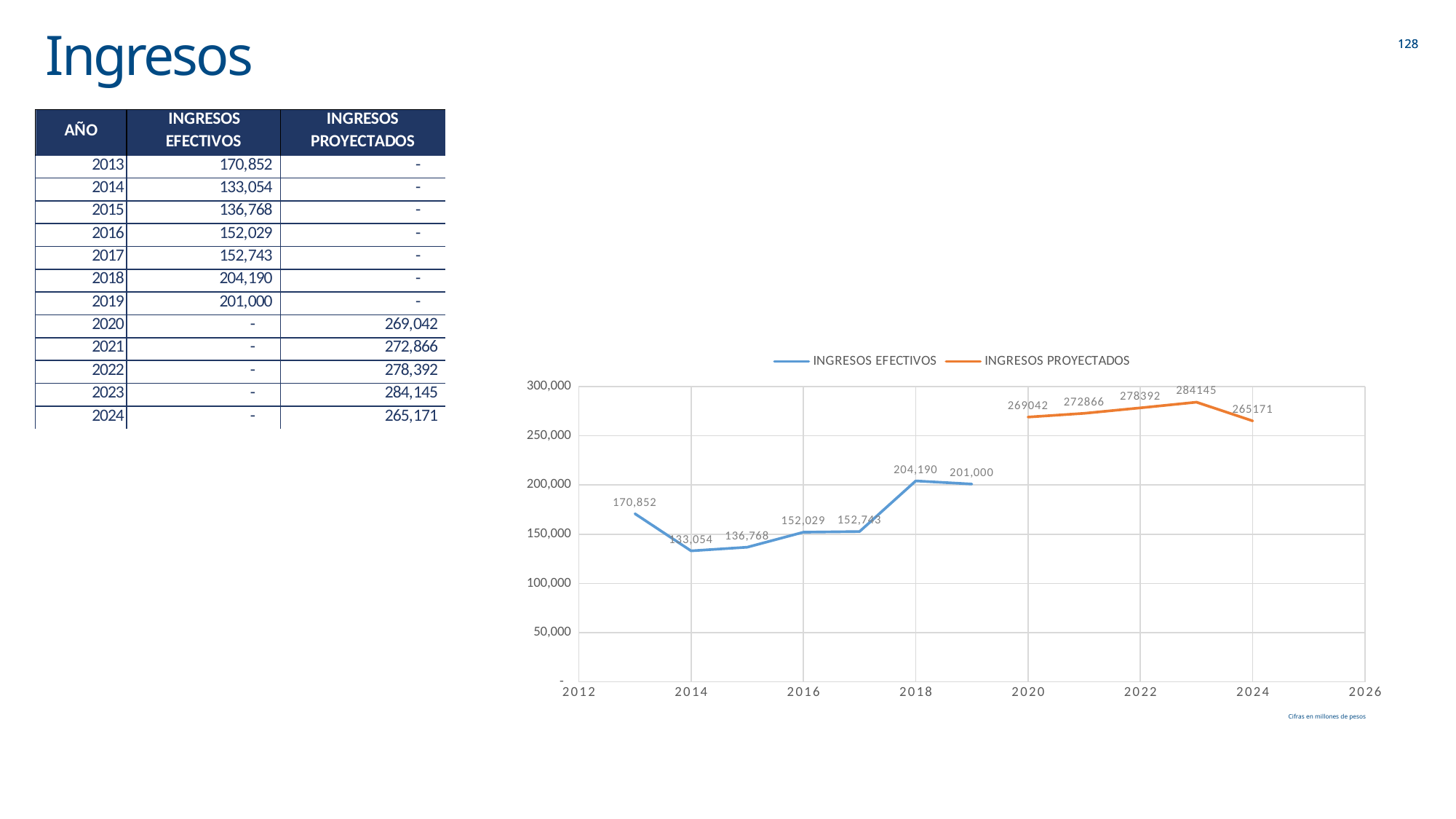
Which is larger, the INGRESOS PROYECTADOS value for 2020 or for 2024? 2020 What kind of chart is shown on the slide? line chart Which year has the highest value in the INGRESOS PROYECTADOS series? 2023 Which colour is used for the INGRESOS PROYECTADOS line? orange What is the value of INGRESOS EFECTIVOS for 2013? 170,852 What is the difference between the INGRESOS EFECTIVOS values for 2018 and 2019? 3,190 What is the value of INGRESOS PROYECTADOS for 2023? 284145 How many data points are plotted in the INGRESOS EFECTIVOS series? 7 Which year has the lowest value in the INGRESOS EFECTIVOS series? 2014 How many series does the chart legend list? 2 Is the INGRESOS EFECTIVOS value for 2016 greater or less than 200,000? less What is the value of INGRESOS EFECTIVOS for 2018? 204,190